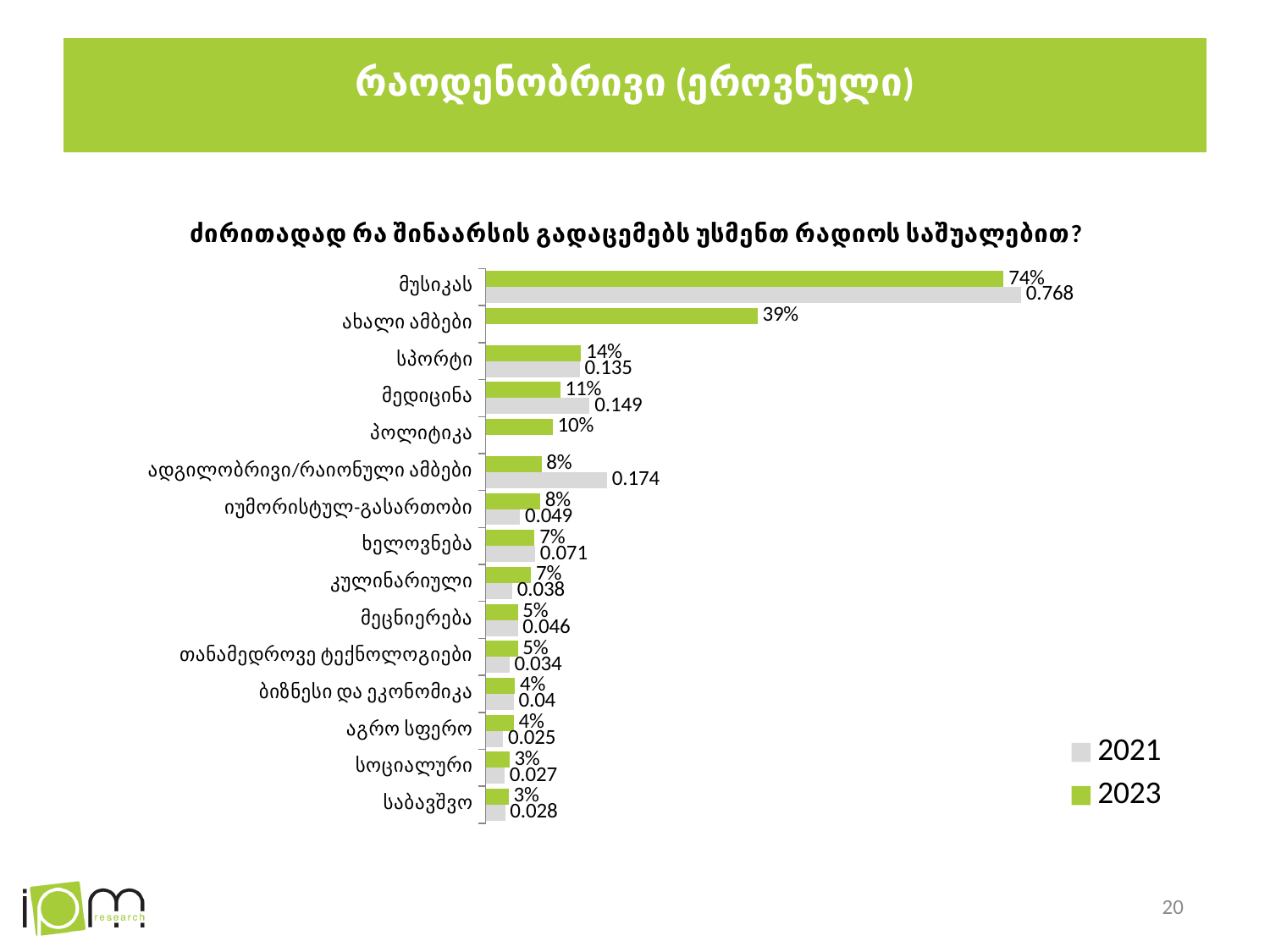
How many categories are shown on the chart? 15 What is the 2023 value for ახალი ამბები? 39% Which category has the highest 2023 value? მუსიკას What kind of chart is shown on the slide? Bar chart What is the 2021 value for მუსიკას? 0.768 What is the 2021 value for სპორტი? 0.135 What is the 2021 value for ადგილობრივი/რაიონული ამბები? 0.174 Which is larger: the 2023 value for მედიცინა or the 2023 value for პოლიტიკა? მედიცინა What is the difference between the 2023 values for მუსიკას and ახალი ამბები? 35% Which category has the lowest 2021 value? აგრო სფერო What is the 2023 value for მუსიკას? 74% How many series does the legend list? 2